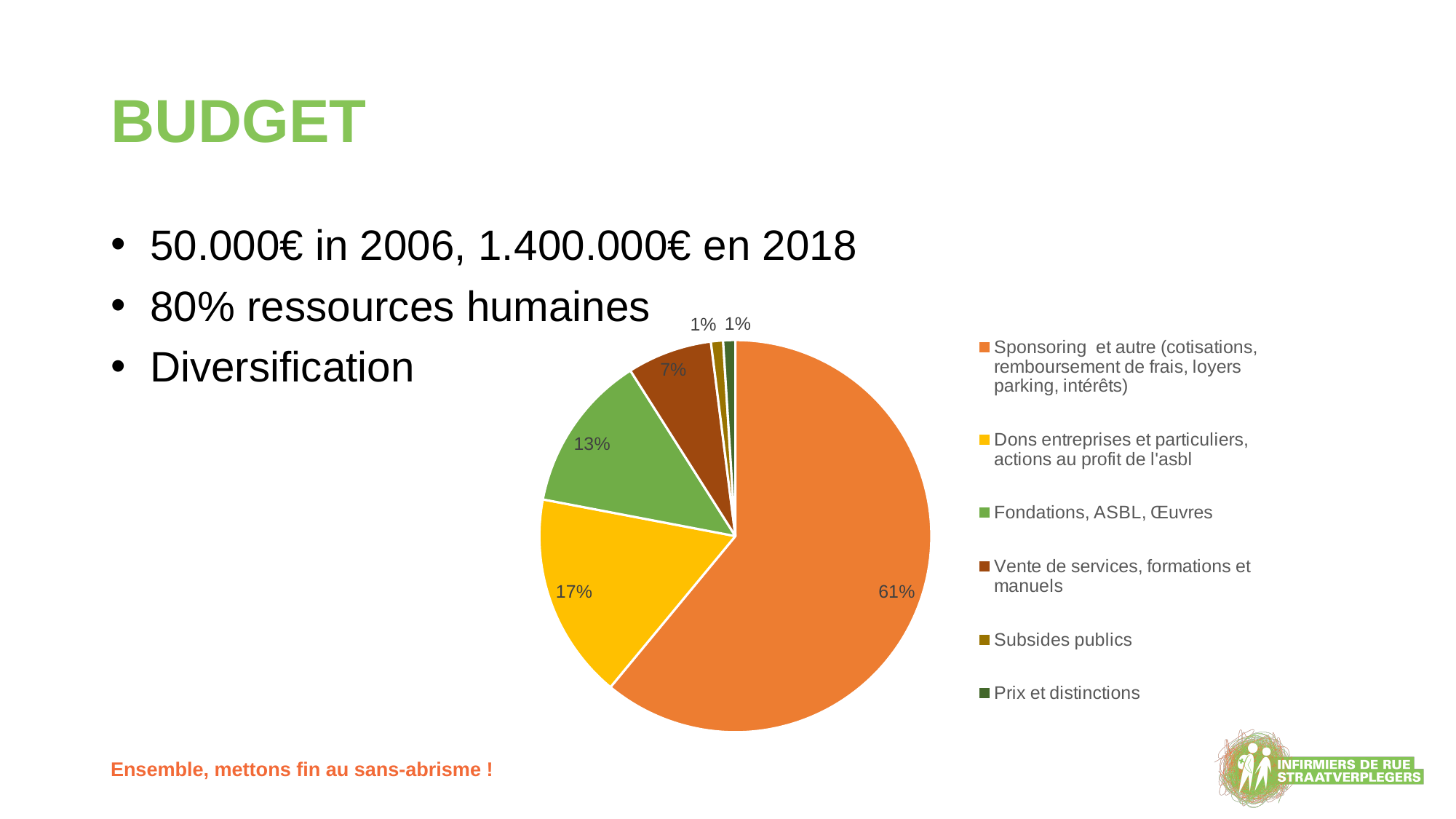
How many slices does the pie chart have? 6 What share of the pie does "Vente de services, formations et manuels" represent? 7% What kind of chart is shown on the slide? pie chart What share of the pie does "Subsides publics" represent? 1% What share of the pie does "Sponsoring et autre" represent? 61% What is the difference in percentage points between the "Sponsoring et autre" slice and the "Dons entreprises et particuliers" slice? 44 Which category has the largest slice of the pie? Sponsoring et autre (cotisations, remboursement de frais, loyers parking, intérêts) How many entries does the legend list? 6 What colour is the "Sponsoring et autre" slice in the pie chart? orange Which slice is larger: "Fondations, ASBL, Œuvres" or "Vente de services, formations et manuels"? Fondations, ASBL, Œuvres